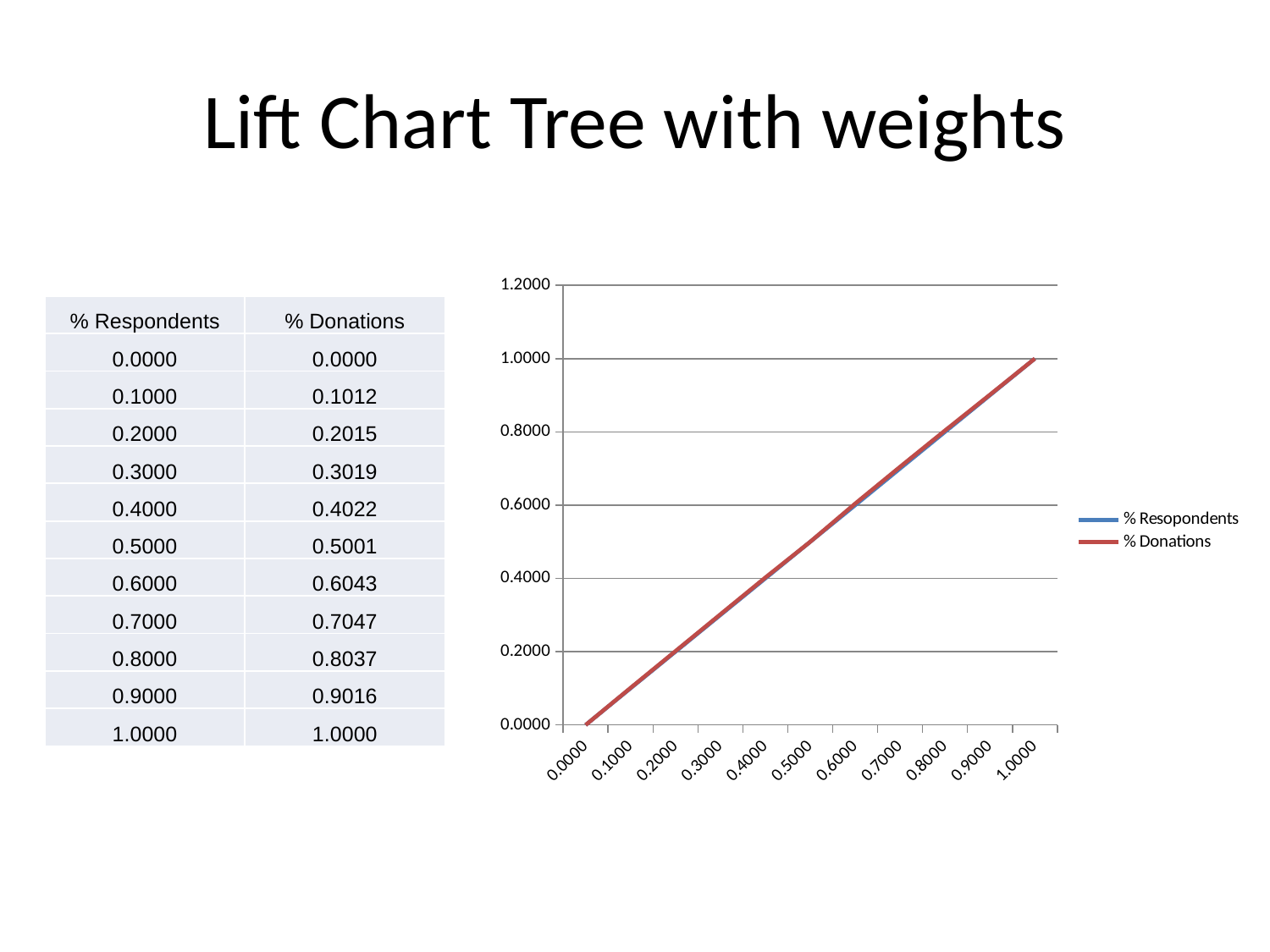
How many series does the chart legend list? 2 What is the % Donations value when % Respondents is 0.5000? 0.5001 What is the lowest % Donations value shown? 0.0000 What is the % Donations value when % Respondents is 0.2000? 0.2015 What kind of chart is shown on the slide? line chart How many points are plotted along the x axis of the chart? 11 Is the % Donations value at x = 0.9000 greater or less than 0.8000? greater What colour is the % Donations line in the chart? red What is the % Donations value when % Respondents is 0.7000? 0.7047 What is the highest % Donations value shown? 1.0000 Do the values of the % Donations series rise or fall as you move along the x axis? rise What are the two series named in the chart legend? % Resopondents and % Donations